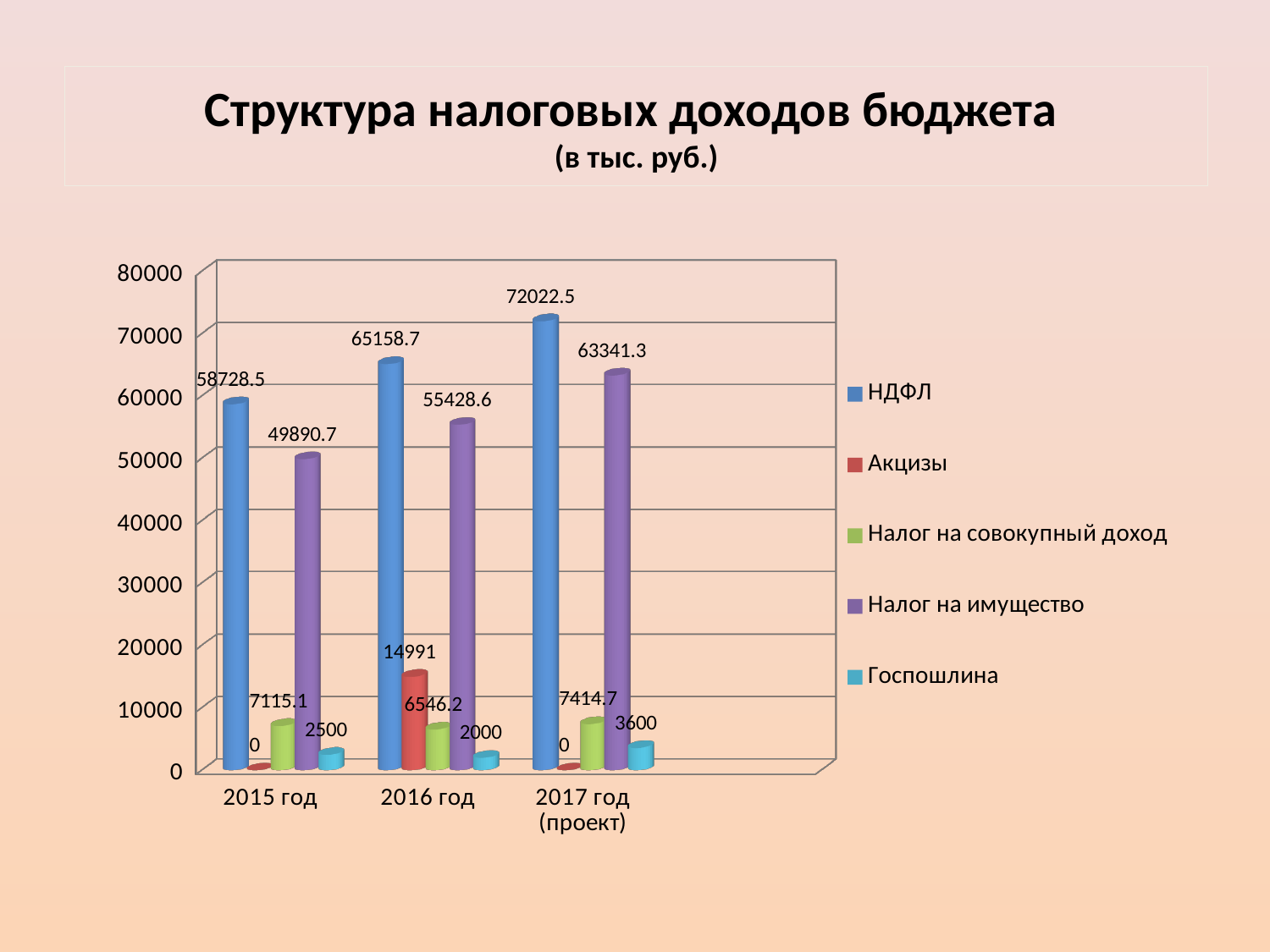
In which year is НДФЛ the highest? 2017 год (проект) What is the value of Госпошлина for 2017 год (проект)? 3600 Does the value of Налог на имущество rise or fall from 2015 год to 2017 год (проект)? Rises What kind of chart is shown on the slide? Bar chart What is the value of Акцизы for 2016 год? 14991 In which year is Госпошлина the lowest? 2016 год What is the value of Налог на имущество for 2015 год? 49890.7 How many years (categories) are shown on the x axis? 3 What is the value of НДФЛ for 2017 год (проект)? 72022.5 Which is larger in 2016 год: Акцизы or Налог на совокупный доход? Акцизы How many series does the legend list? 5 What is the difference between НДФЛ in 2016 год and in 2015 год? 6430.2